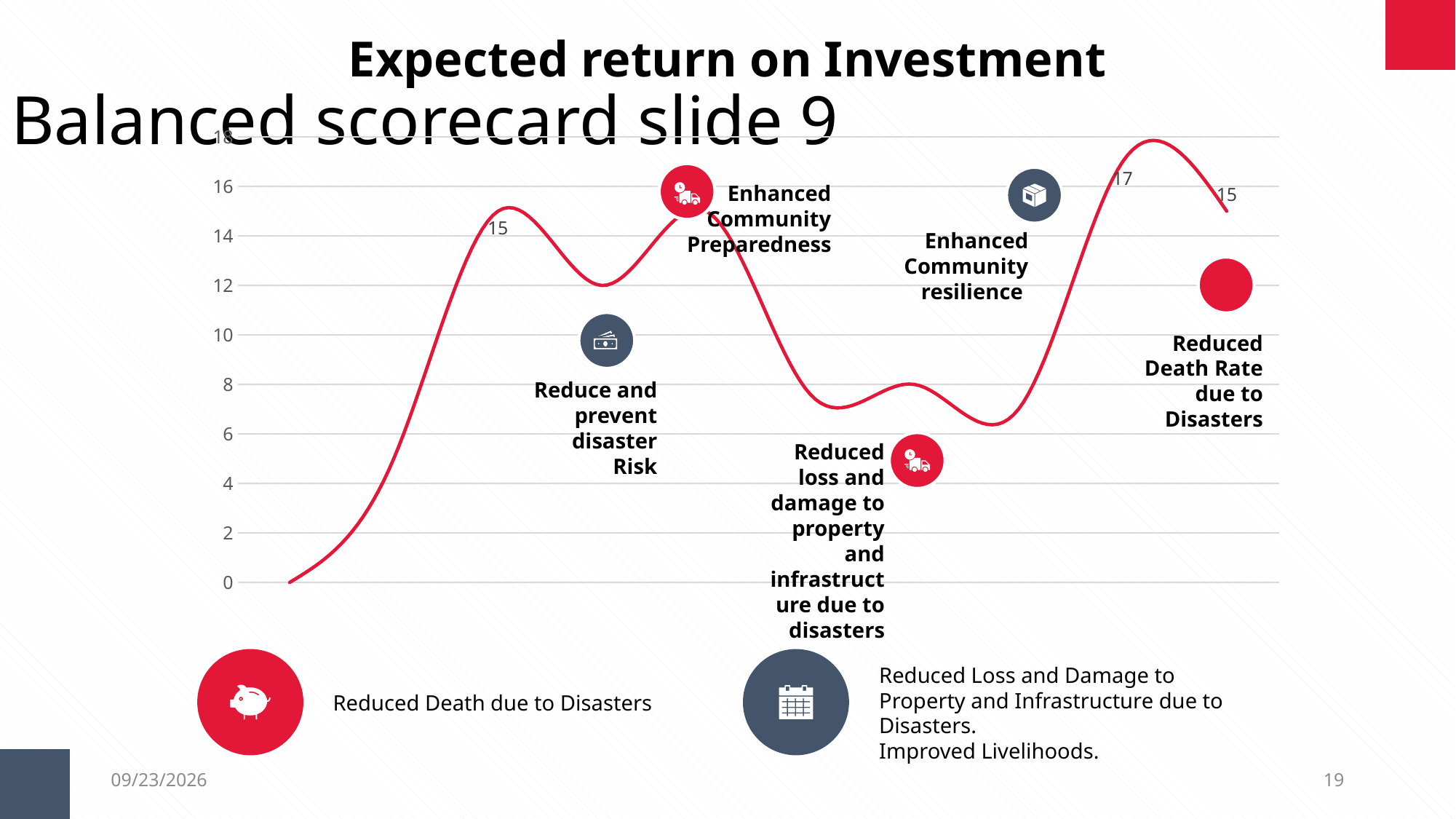
What value is labelled at the first peak of the line, on the left side of the chart? 15 What colour is the plotted line? red Is the value at the lowest trough in the middle of the chart greater or less than 8? less What is the title of the chart? Expected return on Investment Which is larger: the value labelled at the tallest peak or the value labelled at the end of the line? the tallest peak (17) What kind of chart is shown on the slide? line chart What value is labelled at the final point of the line, at the right end of the chart? 15 What is the highest data label printed on the line? 17 How many data labels are printed on the line? 3 What is the difference between the highest labelled value (17) and the final labelled value (15)? 2 Is the value at the tallest peak of the line greater or less than 16? greater At what value does the line start at the left of the chart? 0